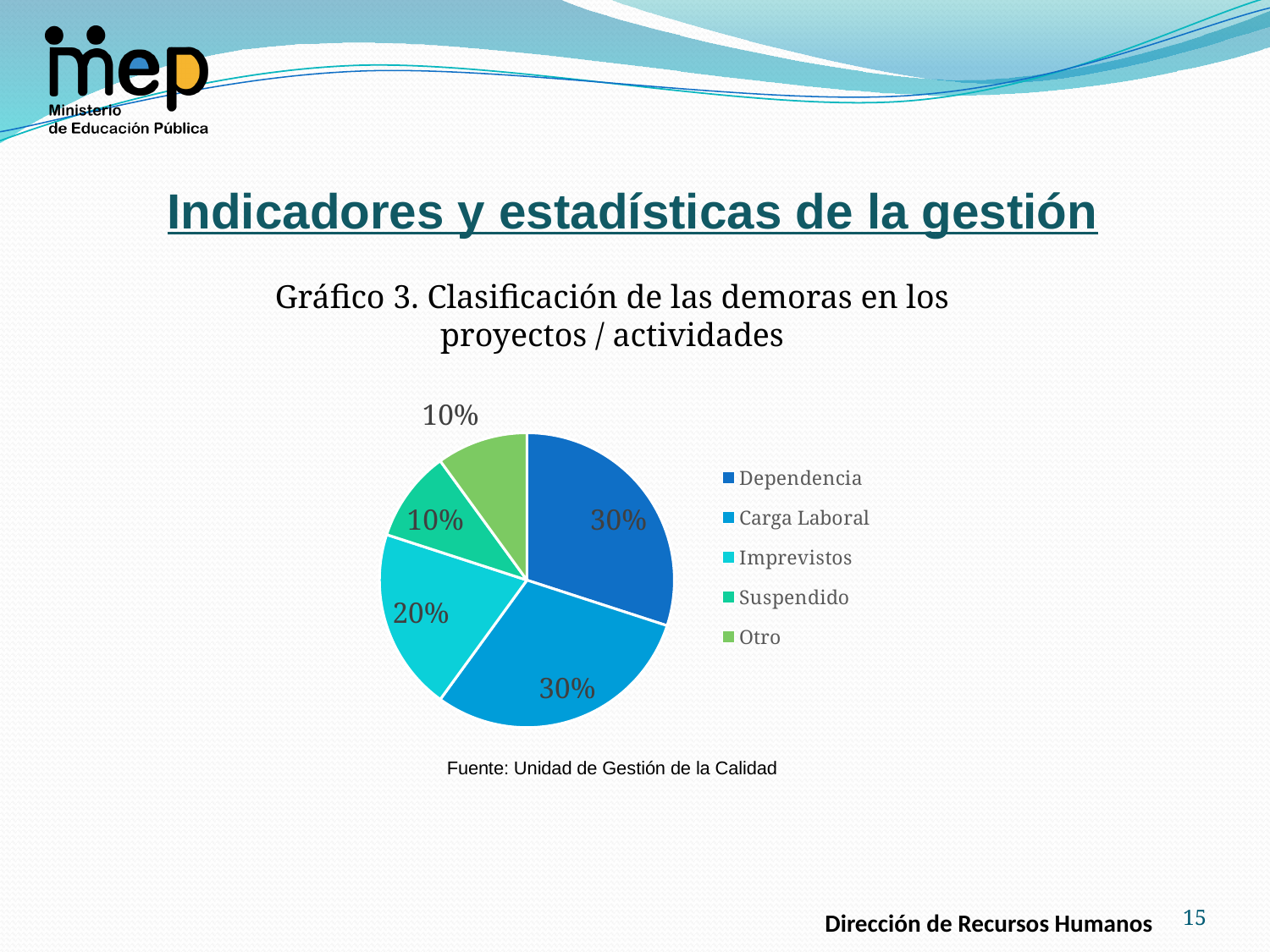
What share of the pie does Suspendido represent? 10% What is the title of the chart? Gráfico 3. Clasificación de las demoras en los proyectos / actividades Which is larger, the share for Imprevistos or the share for Otro? Imprevistos What share of the pie does Otro represent? 10% How many entries does the legend list? 5 What share of the pie does Carga Laboral represent? 30% Which is larger, the share for Carga Laboral or the share for Suspendido? Carga Laboral How many categories does the pie chart have? 5 What is the difference in percentage points between the share for Dependencia and the share for Imprevistos? 10 percentage points What type of chart is shown on the slide? Pie chart What share of the pie does Imprevistos represent? 20% What share of the pie does Dependencia represent? 30%